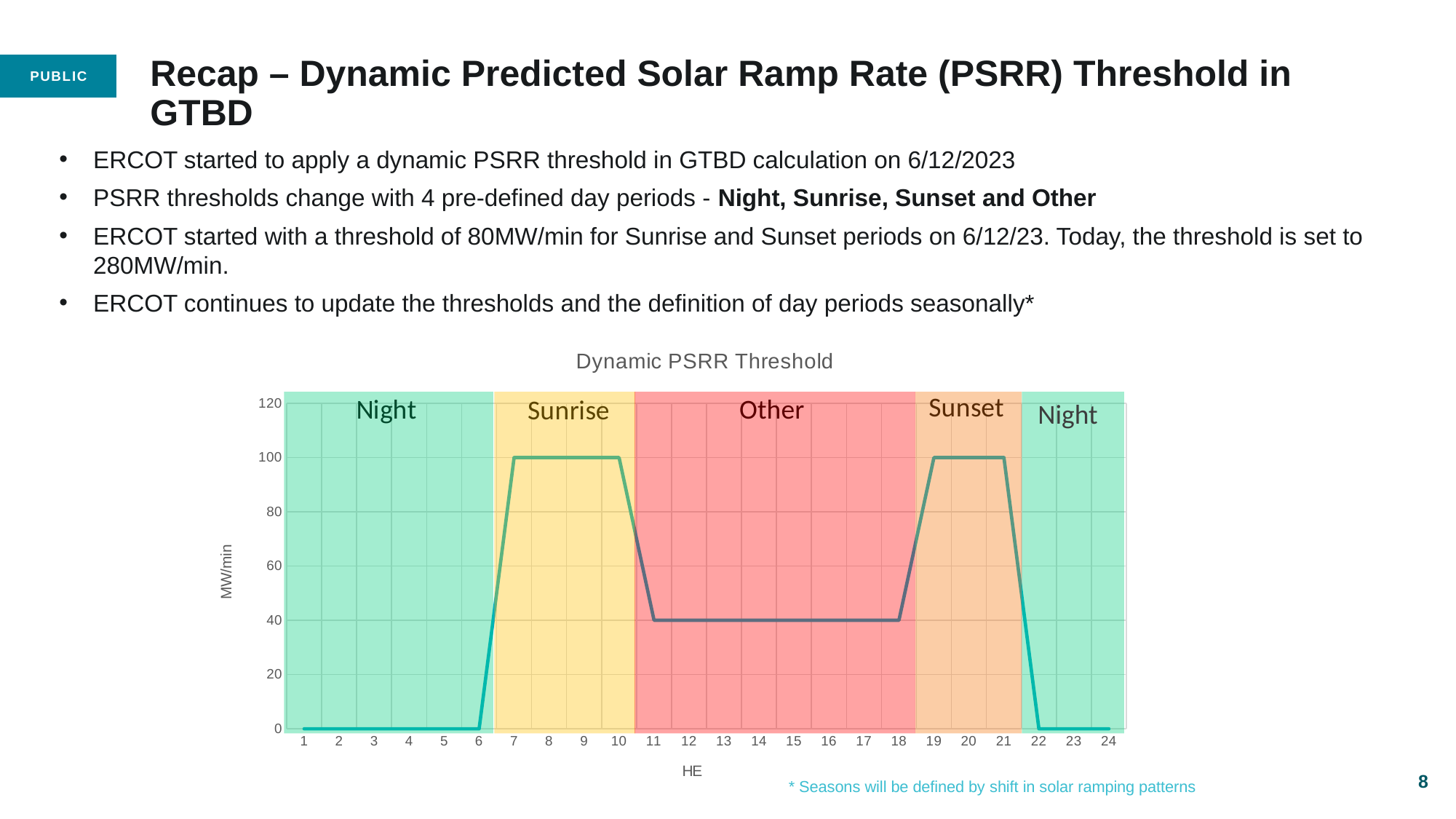
What is the value of the line at HE 20? 100 What kind of chart is shown on the slide? line chart How many HE points are shown on the x axis? 24 What is the value of the line at HE 14? 40 What is the label of the y axis? MW/min Does the line rise or fall between HE 10 and HE 11? fall Is the value of the line at HE 16 greater or less than 60? less What is the value of the line at HE 8? 100 What is the title of the chart? Dynamic PSRR Threshold What is the difference between the line's value at HE 9 and its value at HE 15? 60 Which is larger, the value at HE 12 or the value at HE 19? HE 19 What is the value of the line at HE 3? 0